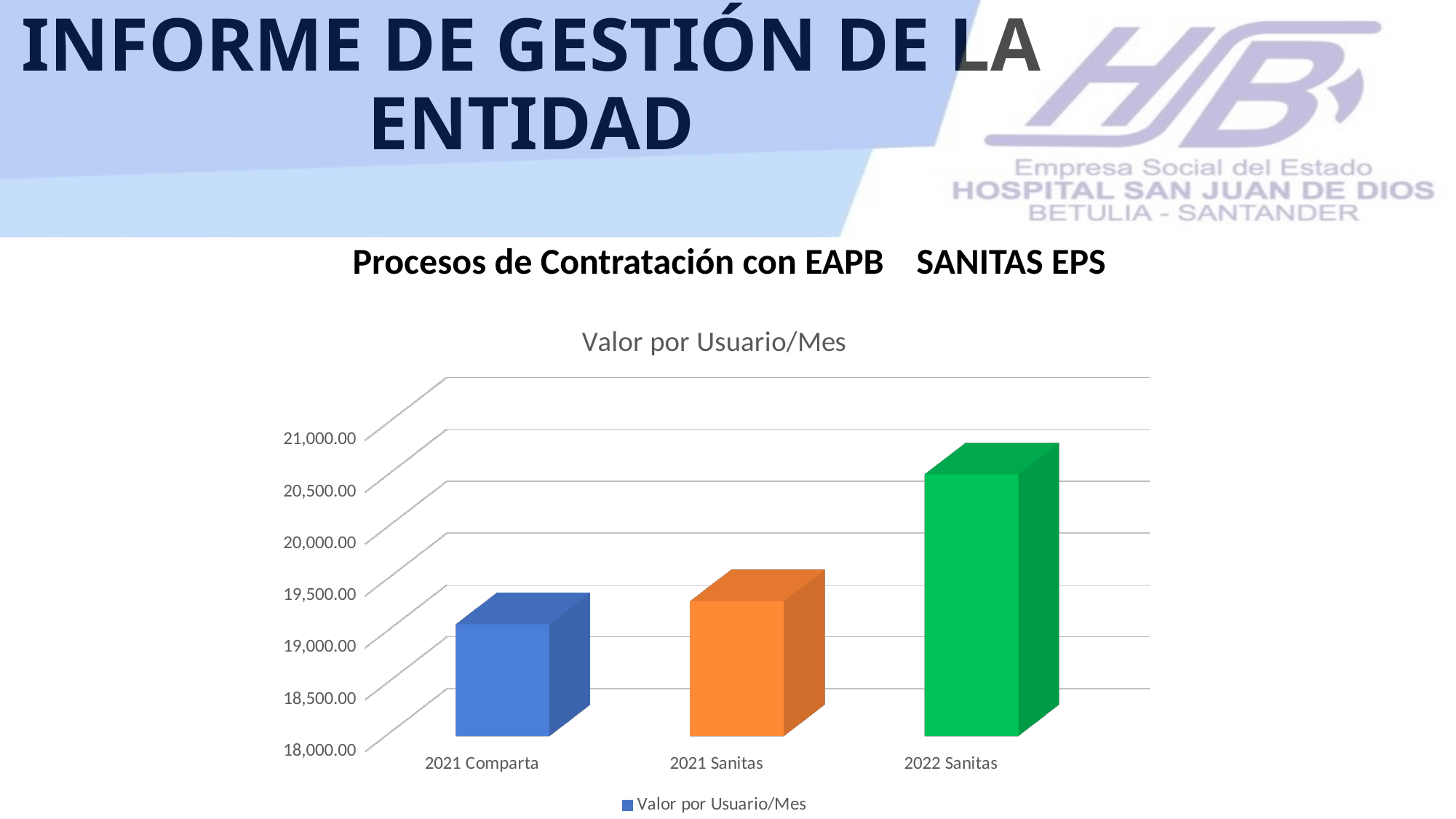
Which is larger, the value for 2022 Sanitas or the value for 2021 Comparta? 2022 Sanitas Is the value for 2021 Sanitas greater or less than 19,000.00? greater How many series does the chart legend list? 1 Do the values rise or fall from left to right along the x axis? Rise Is the value for 2022 Sanitas greater or less than 20,000.00? greater Is the value for 2021 Comparta greater or less than 19,500.00? less Which category has the lowest value in the chart? 2021 Comparta What kind of chart is shown on the slide? Bar chart What is the title of the chart? Valor por Usuario/Mes Which category has the highest value in the chart? 2022 Sanitas How many categories are plotted on the x axis of the chart? 3